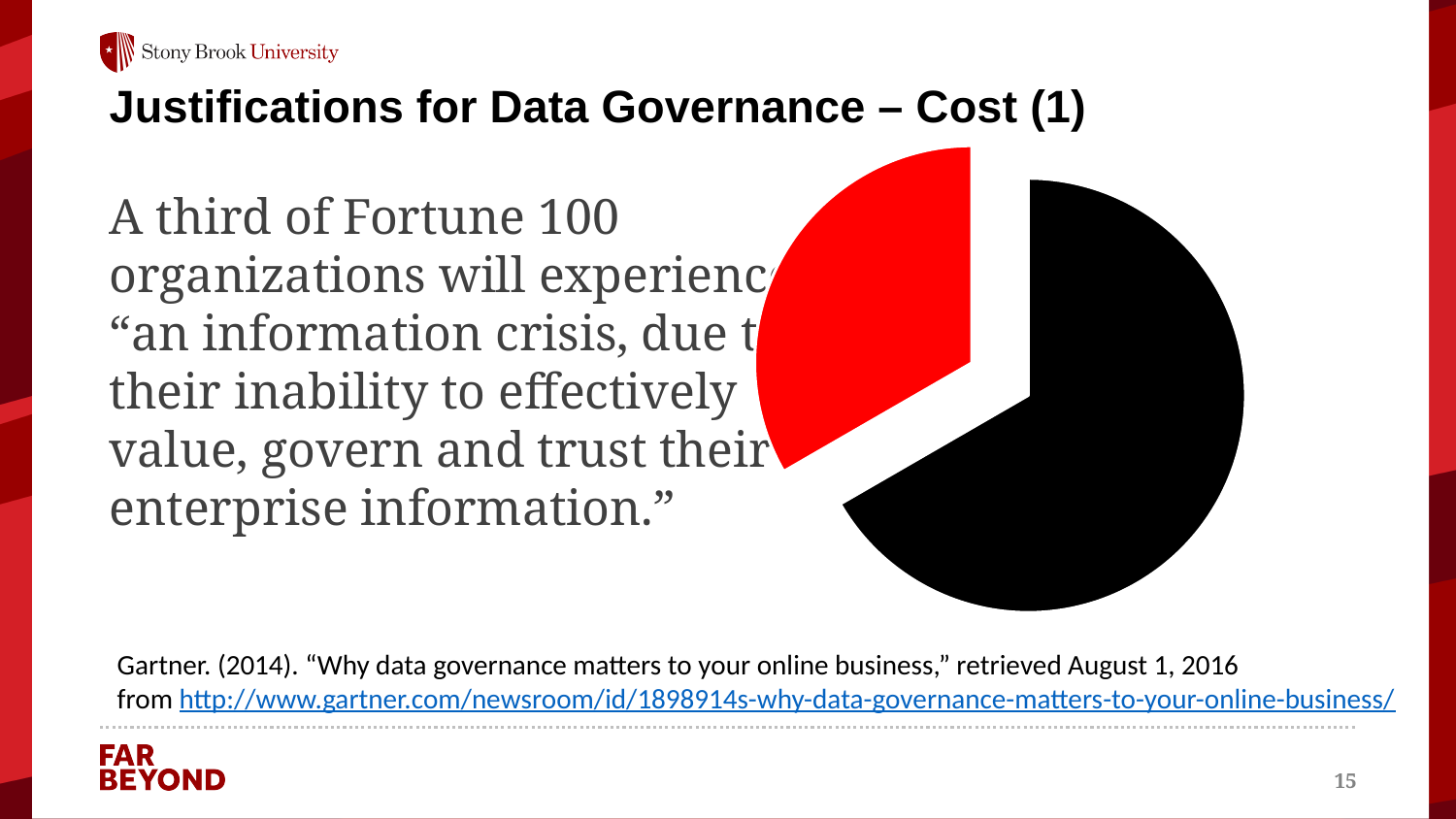
According to the slide text, what fraction of Fortune 100 organizations does the red slice of the pie chart represent? A third Which slice of the pie chart is larger, the red one or the black one? The black one Which slice of the pie chart is pulled out (exploded) from the rest of the pie? The red slice Which slice of the pie chart is smaller, the red one or the black one? The red one What two colours are used for the slices of the pie chart? Red and black Does the pie chart display a legend? No What kind of chart is shown on the slide? Pie chart How many slices does the pie chart have? 2